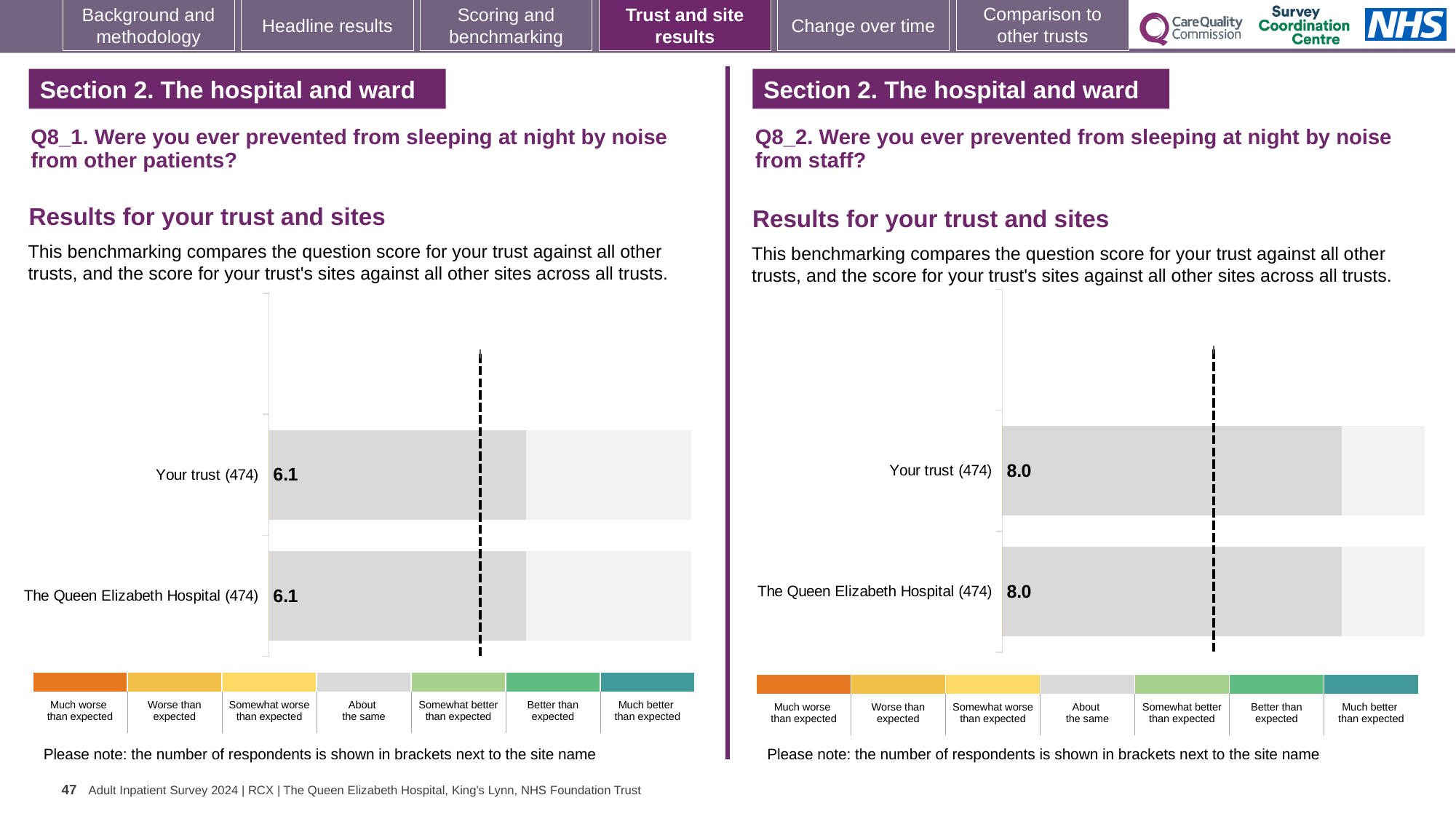
On the Q8_2 chart (right), what is the score for Your trust? 8.0 Is the score for Your trust on the Q8_2 chart (right) larger or smaller than the score for Your trust on the Q8_1 chart (left)? Larger On the Q8_1 chart (left), what is the score for Your trust? 6.1 On the Q8_1 chart (left), what is the difference between the score for Your trust and the score for The Queen Elizabeth Hospital? 0.0 What kind of chart is the Q8_1 chart (left)? Bar chart On the Q8_1 chart (left), how many respondents are shown in brackets next to Your trust? 474 On the Q8_1 chart (left), what is the score for The Queen Elizabeth Hospital? 6.1 How many bars are plotted on the Q8_2 chart (right)? 2 How many colour bands does the legend below the Q8_2 chart (right) show? 7 On the Q8_2 chart (right), what is the score for The Queen Elizabeth Hospital? 8.0 How many bars are plotted on the Q8_1 chart (left)? 2